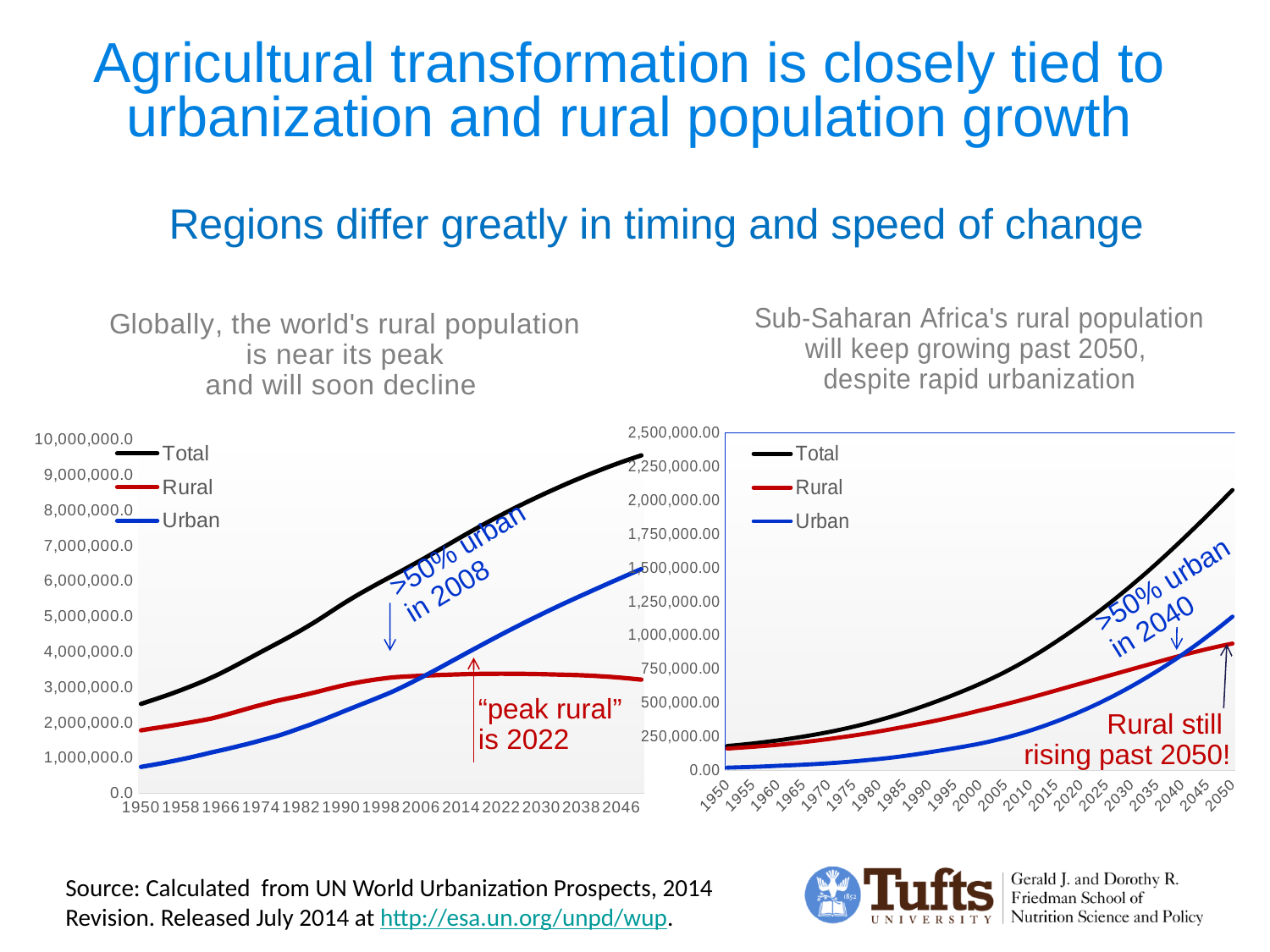
In the right chart (Sub-Saharan Africa), is the value of the Rural line in 1950 greater or less than 250,000.00? less In the right chart (Sub-Saharan Africa), does the Urban line rise or fall from 1950 to 2050? rise In the left chart (global), which is larger in 1950, the Rural value or the Urban value? Rural According to the annotation on the left chart (global), in which year is "peak rural"? 2022 According to the annotation on the right chart (Sub-Saharan Africa), in which year does the population become >50% urban? 2040 In the left chart (global), is the value of the Total line in 2050 greater or less than 9,000,000.0? greater In the right chart (Sub-Saharan Africa), is the value of the Total line in 2050 greater or less than 1,750,000.00? greater What kind of chart is the left chart (global rural population)? line chart How many series does the legend of the right chart (Sub-Saharan Africa) list? 3